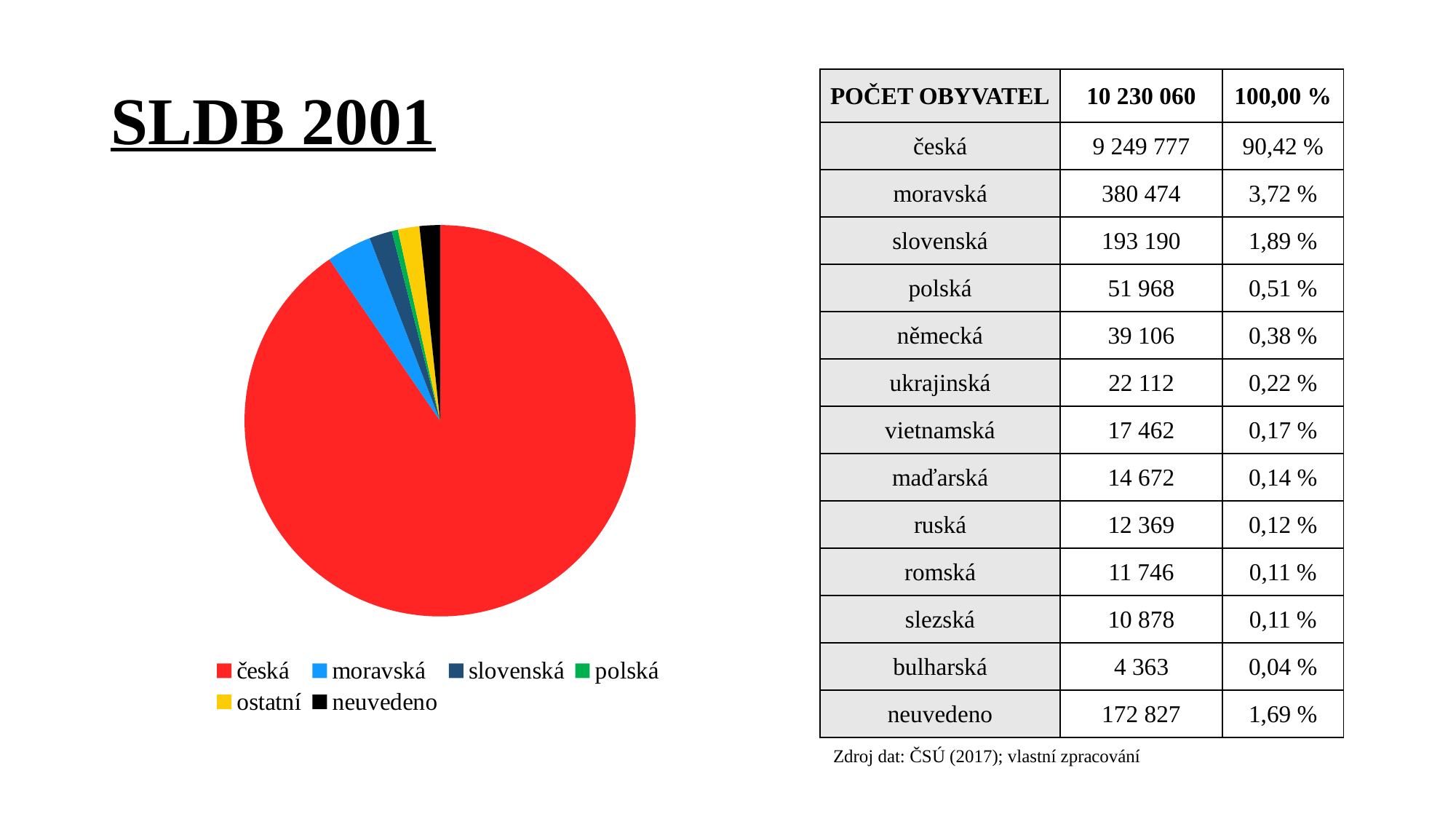
What is the title of the slide containing the pie chart? SLDB 2001 Which category has the largest slice in the pie chart? česká How many slices does the pie chart have? 6 What colour is the česká slice in the pie chart? red Which slice is larger in the pie chart, česká or neuvedeno? česká What share of the pie does the česká slice represent, according to the table on the slide? 90,42 % What is the population count for slovenská shown in the table on the slide? 193 190 Which slice is larger in the pie chart, moravská or slovenská? moravská What kind of chart is shown on the slide? pie chart What share of the pie does the moravská slice represent, according to the table on the slide? 3,72 % Which category has the smallest slice in the pie chart? polská